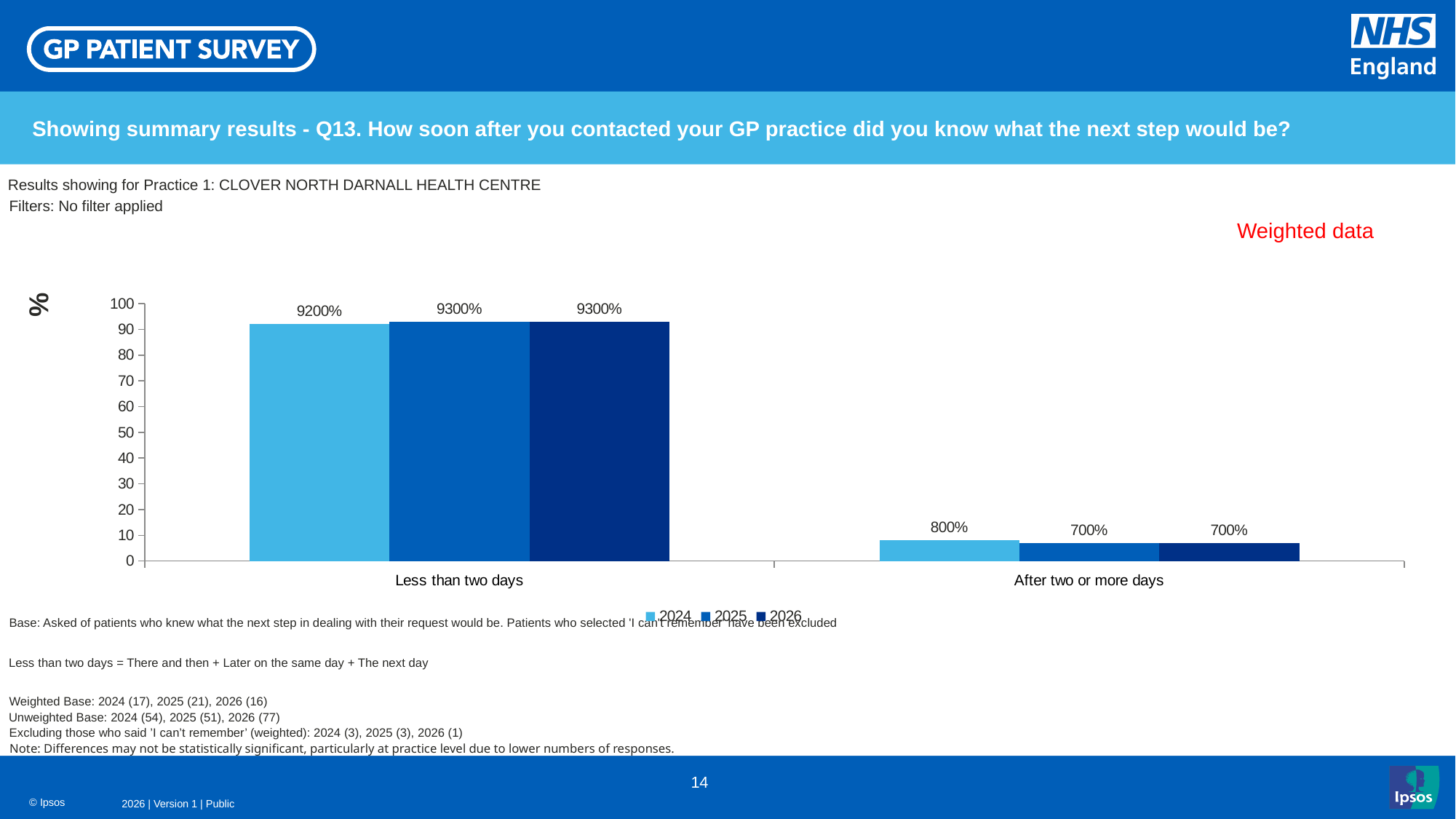
Which year has the lowest value in the 'Less than two days' category? 2024 What is the value for 2025 in the 'Less than two days' category? 9300% How many series does the legend list? 3 Which is larger: the 2024 value for 'Less than two days' or the 2024 value for 'After two or more days'? Less than two days What kind of chart is shown on the slide? Bar chart What is the value for 2026 in the 'After two or more days' category? 700% Which practice are the results shown for? CLOVER NORTH DARNALL HEALTH CENTRE What is the difference between the 2024 and 2025 values in the 'After two or more days' category, as labelled? 100% What is the value for 2024 in the 'After two or more days' category? 800% What is the value for 2024 in the 'Less than two days' category? 9200% Which year has the highest value in the 'After two or more days' category? 2024 How many categories are shown on the x axis? 2